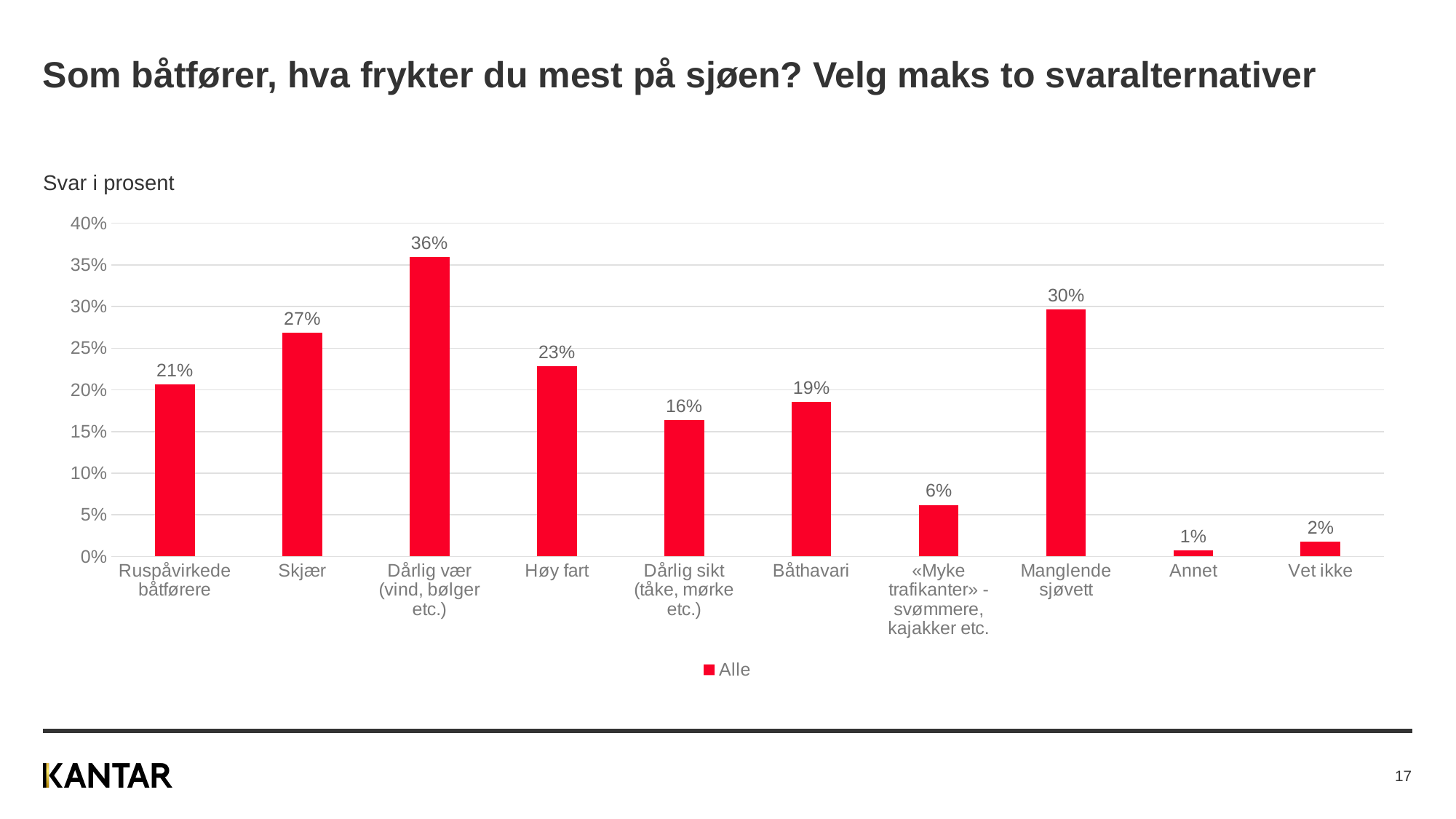
What is the value for Skjær? 27% Which category has the lowest value? Annet Is the value for Ruspåvirkede båtførere greater or less than 25%? less What is the value for Båthavari? 19% Which is larger, the value for Høy fart or the value for Dårlig sikt (tåke, mørke etc.)? Høy fart Which category has the highest value? Dårlig vær (vind, bølger etc.) How many series does the legend list? 1 What is the difference between the values for Dårlig vær (vind, bølger etc.) and Manglende sjøvett? 6% What kind of chart is shown on the slide? bar chart How many categories are shown on the x axis? 10 What is the value for Manglende sjøvett? 30% What is the name of the series shown in the legend? Alle